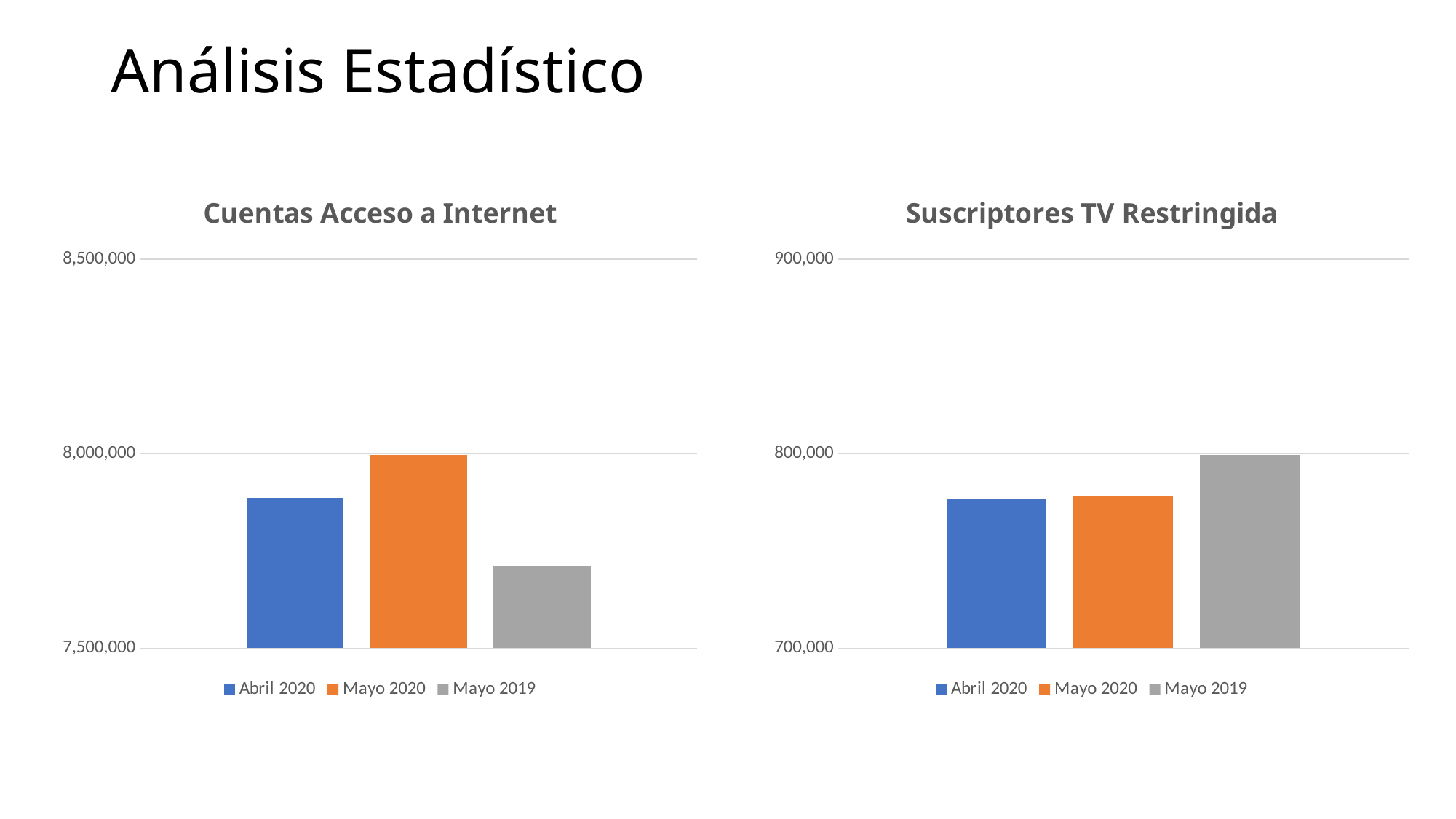
In the "Suscriptores TV Restringida" chart, which is larger, Mayo 2019 or Abril 2020? Mayo 2019 In the "Suscriptores TV Restringida" chart, which series has the highest value? Mayo 2019 In the "Cuentas Acceso a Internet" chart, is the value for Mayo 2019 greater or less than 8,000,000? less In the "Suscriptores TV Restringida" chart, is the value for Abril 2020 greater or less than 800,000? less In the "Suscriptores TV Restringida" chart, what colour is the Mayo 2020 bar? orange How many bars are plotted in the "Suscriptores TV Restringida" chart? 3 In the "Cuentas Acceso a Internet" chart, which series has the lowest value? Mayo 2019 In the "Cuentas Acceso a Internet" chart, which is larger, Abril 2020 or Mayo 2019? Abril 2020 In the "Cuentas Acceso a Internet" chart, is the value for Abril 2020 greater or less than 8,000,000? less How many series does the legend of the "Cuentas Acceso a Internet" chart list? 3 What kind of chart is the "Cuentas Acceso a Internet" chart? bar chart In the "Cuentas Acceso a Internet" chart, which series has the highest value? Mayo 2020